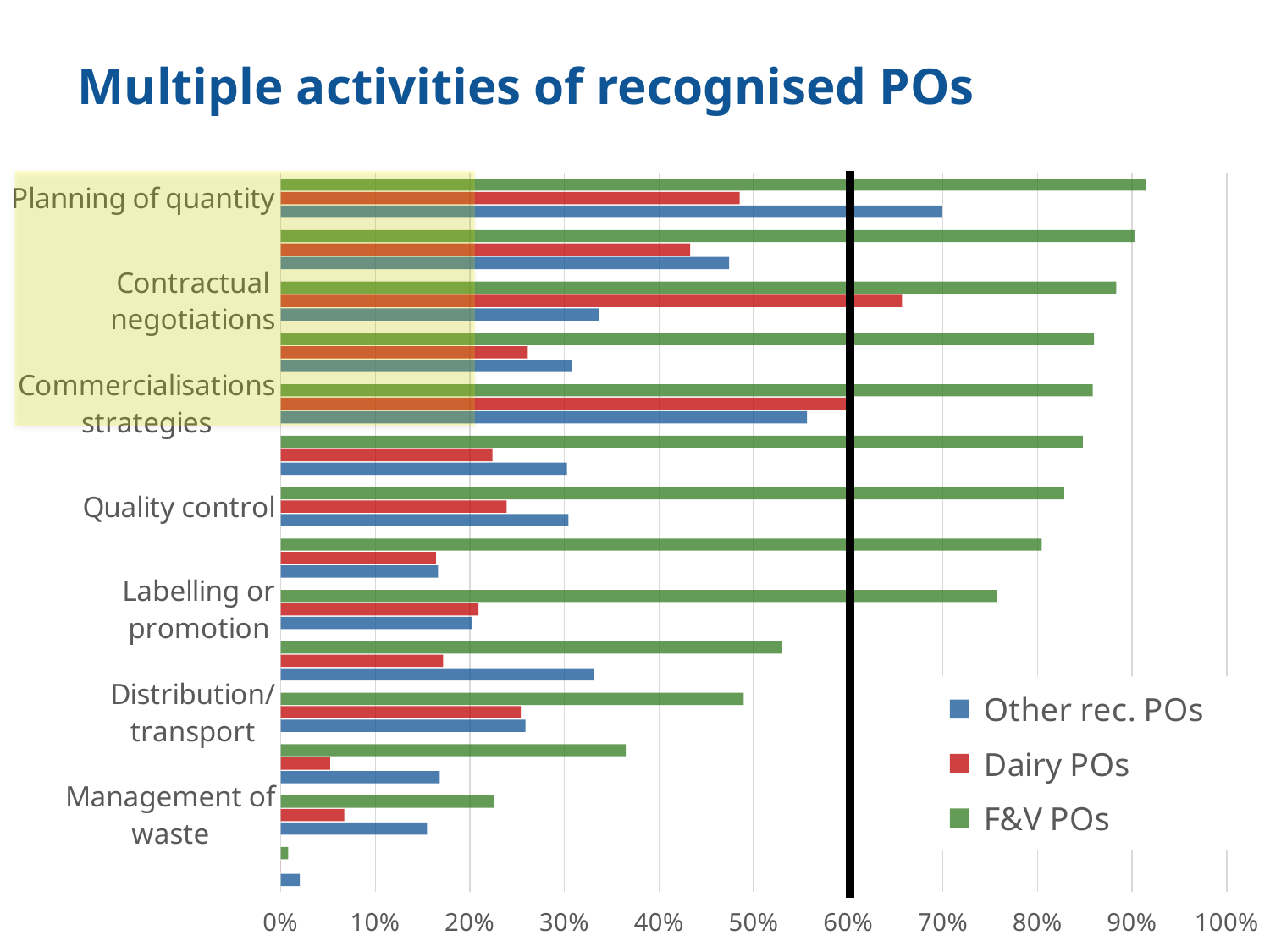
For Contractual negotiations, which is larger: Dairy POs or Other rec. POs? Dairy POs At what percentage on the x axis is the vertical black reference line drawn? 60% Is the value for Dairy POs in Contractual negotiations greater or less than 60%? greater Is the value for Dairy POs in Management of waste greater or less than 10%? less Is the value for F&V POs in Quality control greater or less than 80%? greater How many series does the legend list? 3 What kind of chart is shown on the slide? bar chart For Planning of quantity, which is larger: Other rec. POs or Dairy POs? Other rec. POs For Management of waste, which is larger: Other rec. POs or Dairy POs? Other rec. POs Which series has the highest value for Planning of quantity? F&V POs Which series has the lowest value for Contractual negotiations? Other rec. POs